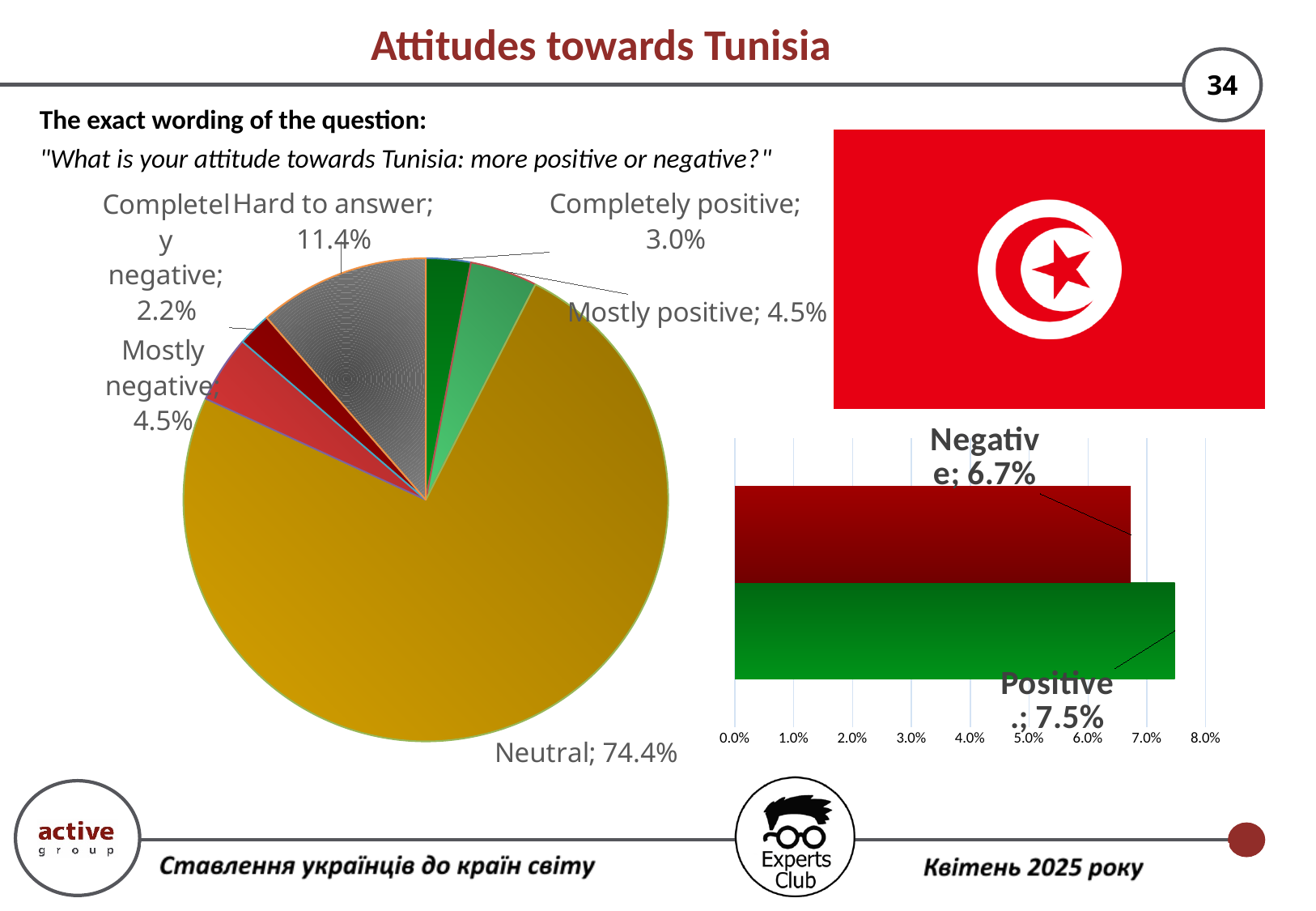
How many categories does the pie chart show? 6 In the pie chart, what share of respondents answered "Hard to answer"? 11.4% In the pie chart, which is larger: "Completely positive" or "Completely negative"? Completely positive In the pie chart, what is the difference between "Hard to answer" and "Completely positive"? 8.4% In the pie chart, what is the value for "Completely positive"? 3.0% What kind of chart is shown on the right side of the slide below the flag? Bar chart In the pie chart, which category has the smallest share? Completely negative In the bar chart on the right, what is the difference between "Positive" and "Negative"? 0.8% In the pie chart, what share of respondents answered "Neutral"? 74.4% In the pie chart, what is the value for "Completely negative"? 2.2% In the bar chart on the right, what is the value for "Positive"? 7.5% In the pie chart, which category has the largest share? Neutral